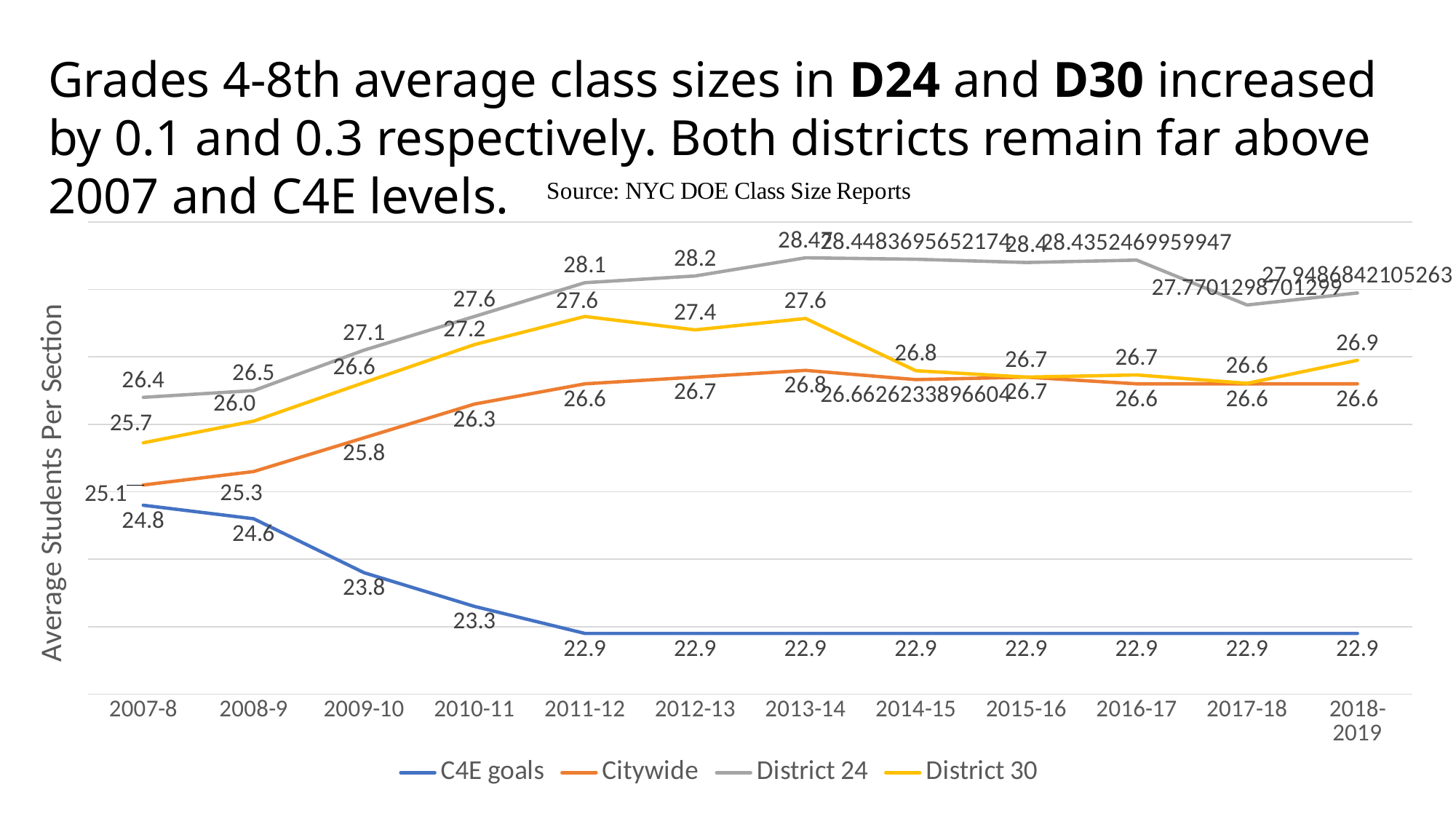
What is the C4E goals value for 2009-10? 23.8 What is the Citywide value for 2010-11? 26.3 What kind of chart is shown on the slide? line chart What is the District 30 value for 2007-8? 25.7 How many series does the legend list? 4 What is the District 24 value for 2012-13? 28.2 What is the District 30 value for 2018-2019? 26.9 How many school years are shown on the x axis? 12 What is the difference between the District 24 and District 30 values in 2011-12? 0.5 Do the C4E goals values rise or fall from 2007-8 to 2011-12? fall In which school year is the Citywide value lowest? 2007-8 In 2009-10, which is larger: District 24 or District 30? District 24